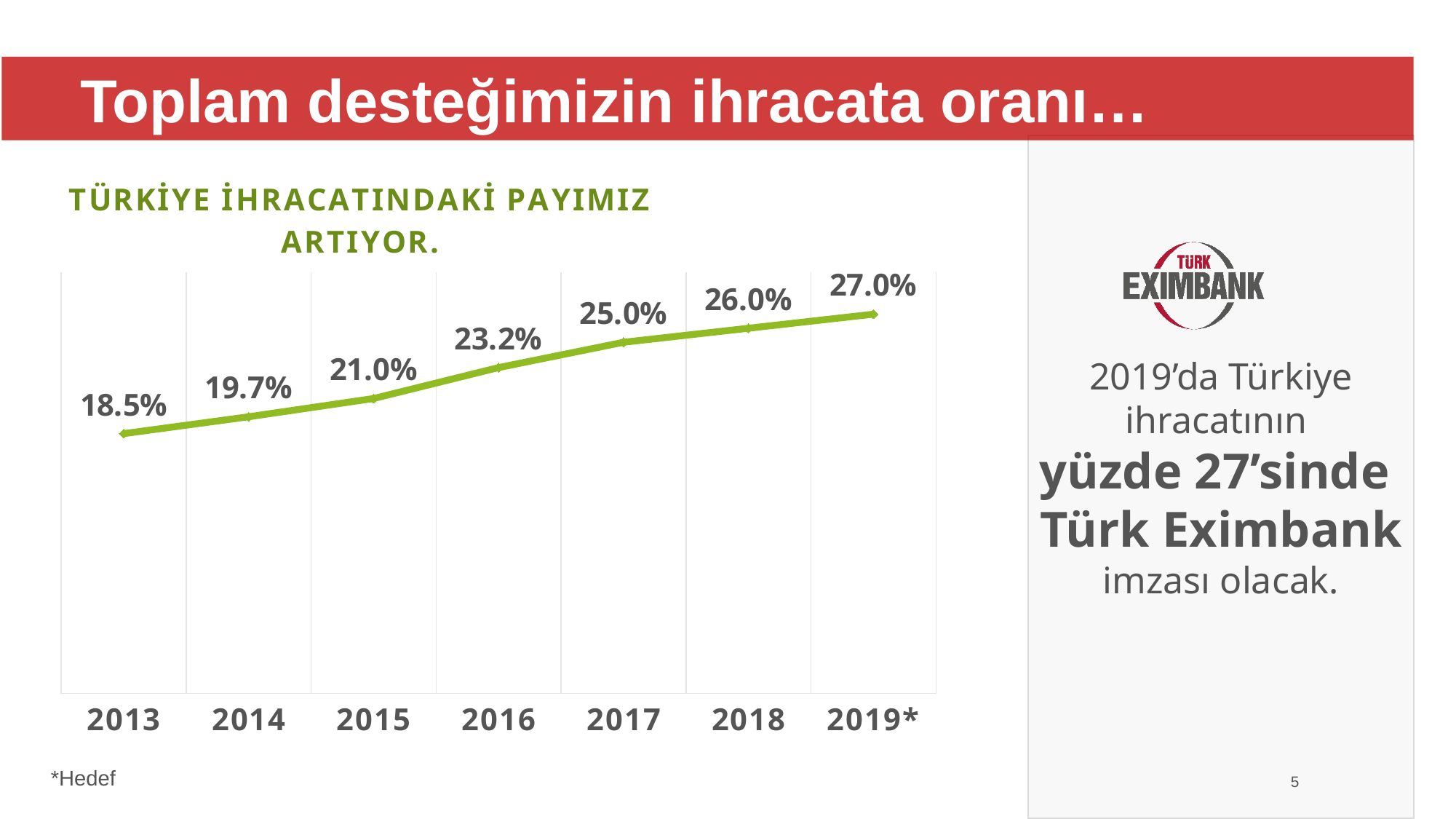
How many years are plotted on the chart? 7 What is the value for 2019*? 27.0% What is the difference between the values for 2016 and 2015? 2.2% Do the values rise or fall from 2013 to 2019*? rise Which is larger, the value for 2017 or the value for 2014? 2017 What is the value for 2013? 18.5% What is the difference between the values for 2019* and 2013? 8.5% What kind of chart is shown? line chart What is the value for 2016? 23.2% Which year has the highest value? 2019* Which year has the lowest value? 2013 What is the title of the chart? TÜRKİYE İHRACATINDAKİ PAYIMIZ ARTIYOR.